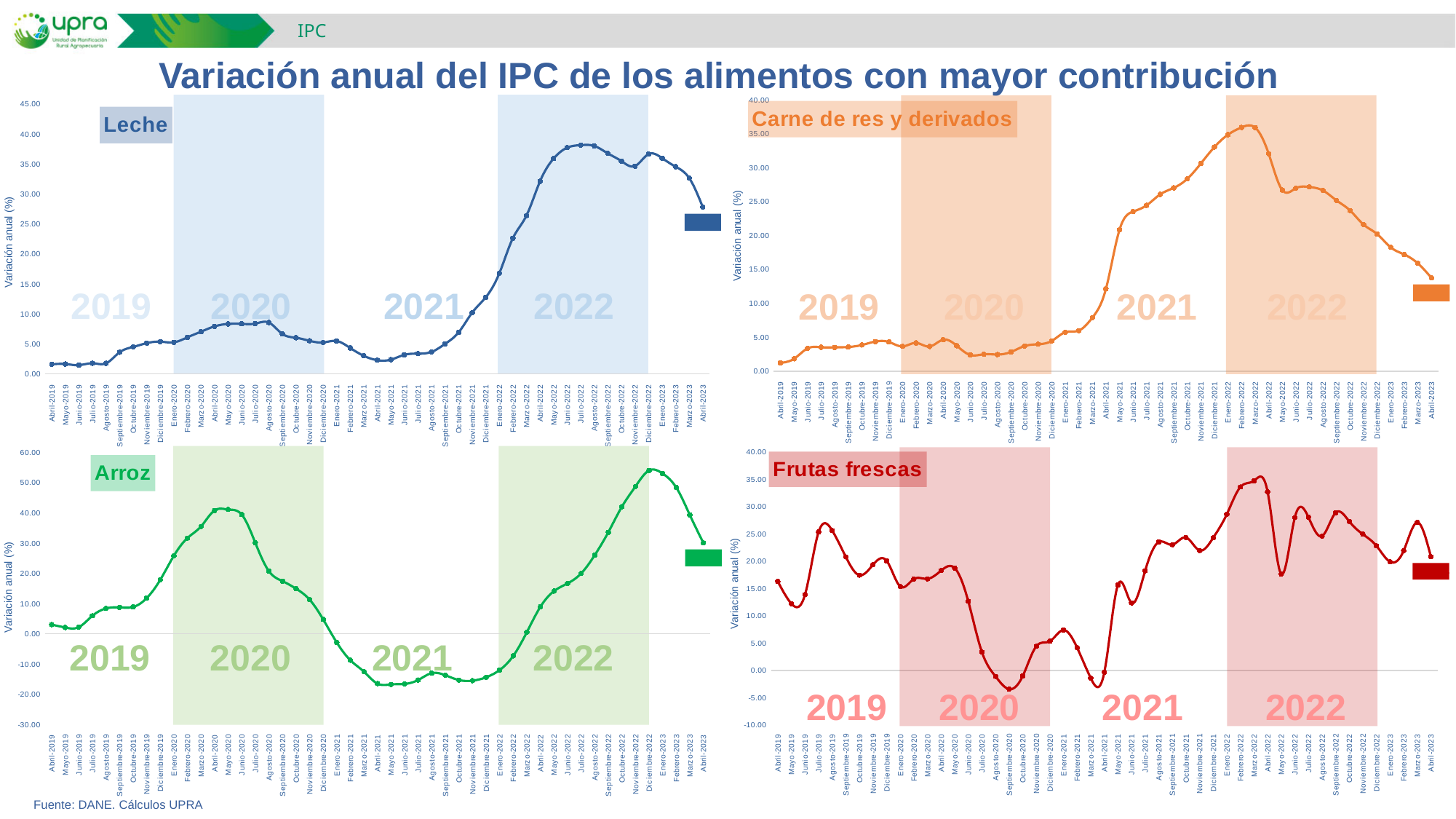
In the 'Carne de res y derivados' chart, is the value for Abril-2023 greater or less than 20? less In the 'Arroz' chart, is the value for Abril-2021 greater or less than -10? less In the 'Frutas frescas' chart, is the value for Marzo-2022 greater or less than 30? greater In the 'Leche' chart, do the values rise or fall from Enero-2022 to Julio-2022? rise In the 'Carne de res y derivados' chart, do the values rise or fall from Marzo-2022 to Abril-2023? fall How many charts are shown on the slide? 4 What kind of chart is the 'Leche' chart? line chart